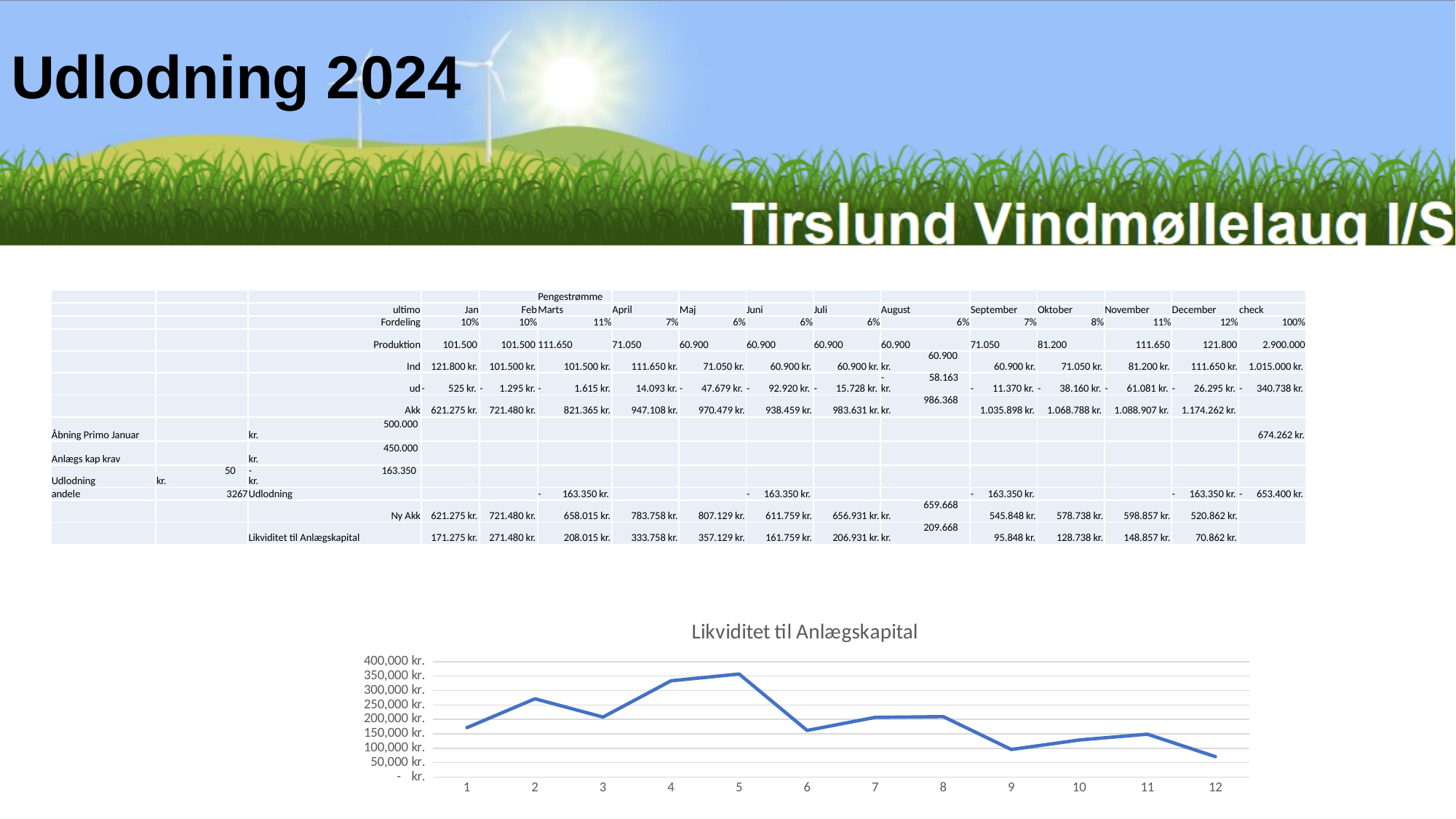
Which has the larger value, point 2 or point 3? point 2 Does the line rise or fall between point 9 and point 11? rise Is the value at point 4 greater or less than 300,000 kr.? greater What kind of chart is shown on the slide? line chart Is the value at point 12 greater or less than 100,000 kr.? less Does the line rise or fall between point 5 and point 6? fall Is the value at point 6 greater or less than 200,000 kr.? less How many points are plotted along the x axis of the chart? 12 At which x-axis point does the line reach its lowest value? 12 At which x-axis point does the line reach its highest value? 5 What is the title of the chart? Likviditet til Anlægskapital